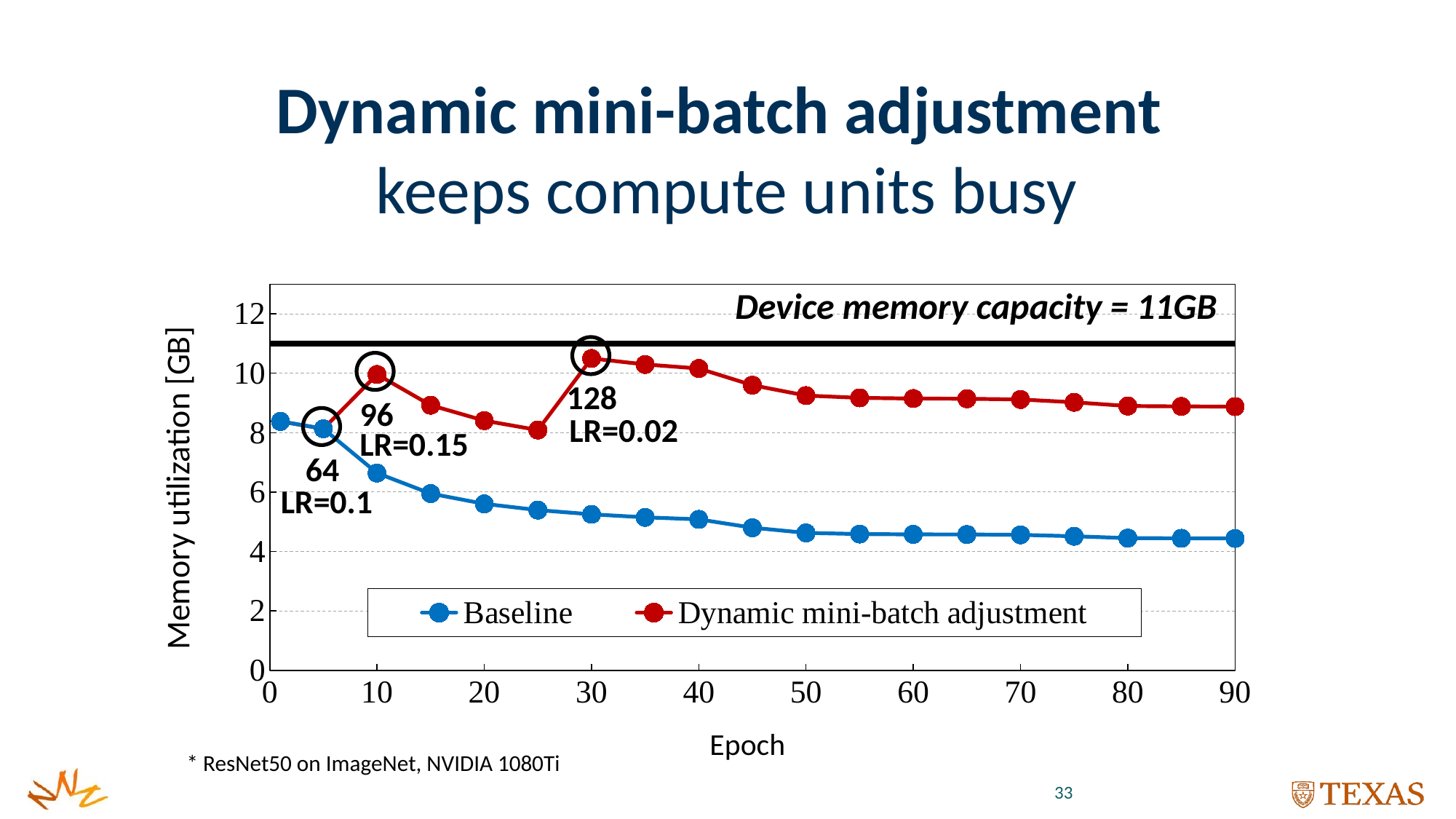
At which epoch does the Dynamic mini-batch adjustment line reach its highest memory utilization? 30 What kind of chart is shown on the slide? line chart At epoch 50, which series has the higher memory utilization? Dynamic mini-batch adjustment What device memory capacity is stated on the chart? 11GB Does the Baseline memory utilization rise or fall as the epoch increases? fall Is the Dynamic mini-batch adjustment memory utilization at epoch 10 greater or less than 8 GB? greater What mini-batch size and learning rate are annotated at epoch 30 on the Dynamic mini-batch adjustment line? 128, LR=0.02 How many series does the legend list? 2 What learning rate is annotated with mini-batch size 96? LR=0.15 What are the two series named in the legend? Baseline; Dynamic mini-batch adjustment Is the Baseline memory utilization at epoch 10 greater or less than 6 GB? greater Is the Baseline memory utilization at epoch 90 greater or less than 6 GB? less